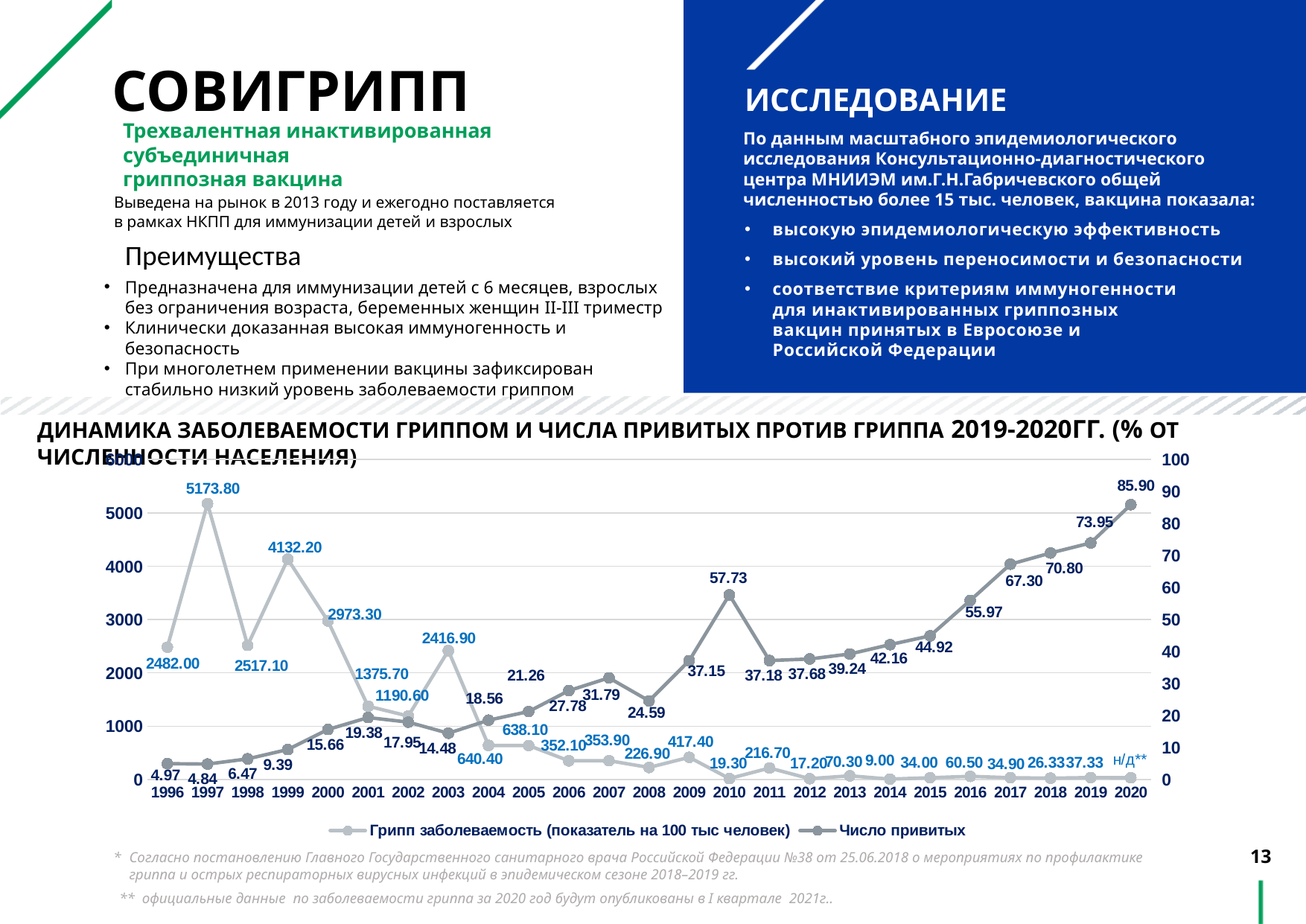
How many years are plotted along the x axis of the chart? 25 What is the value of 'Число привитых' in 2010? 57.73 What is the difference between 'Число привитых' in 2020 and in 2019? 11.95 How many series does the chart legend list? 2 In which year is 'Число привитых' highest? 2020 In which year is 'Грипп заболеваемость' highest? 1997 What is the value of 'Число привитых' in 2020? 85.90 What type of chart is shown on the slide? line chart What is the value of 'Грипп заболеваемость' in 1997? 5173.80 Which is larger for 'Грипп заболеваемость': the value in 1999 or the value in 2000? 1999 What value is shown for 'Грипп заболеваемость' in 2020? н/д** Does 'Число привитых' generally rise or fall from 2011 to 2020? rise